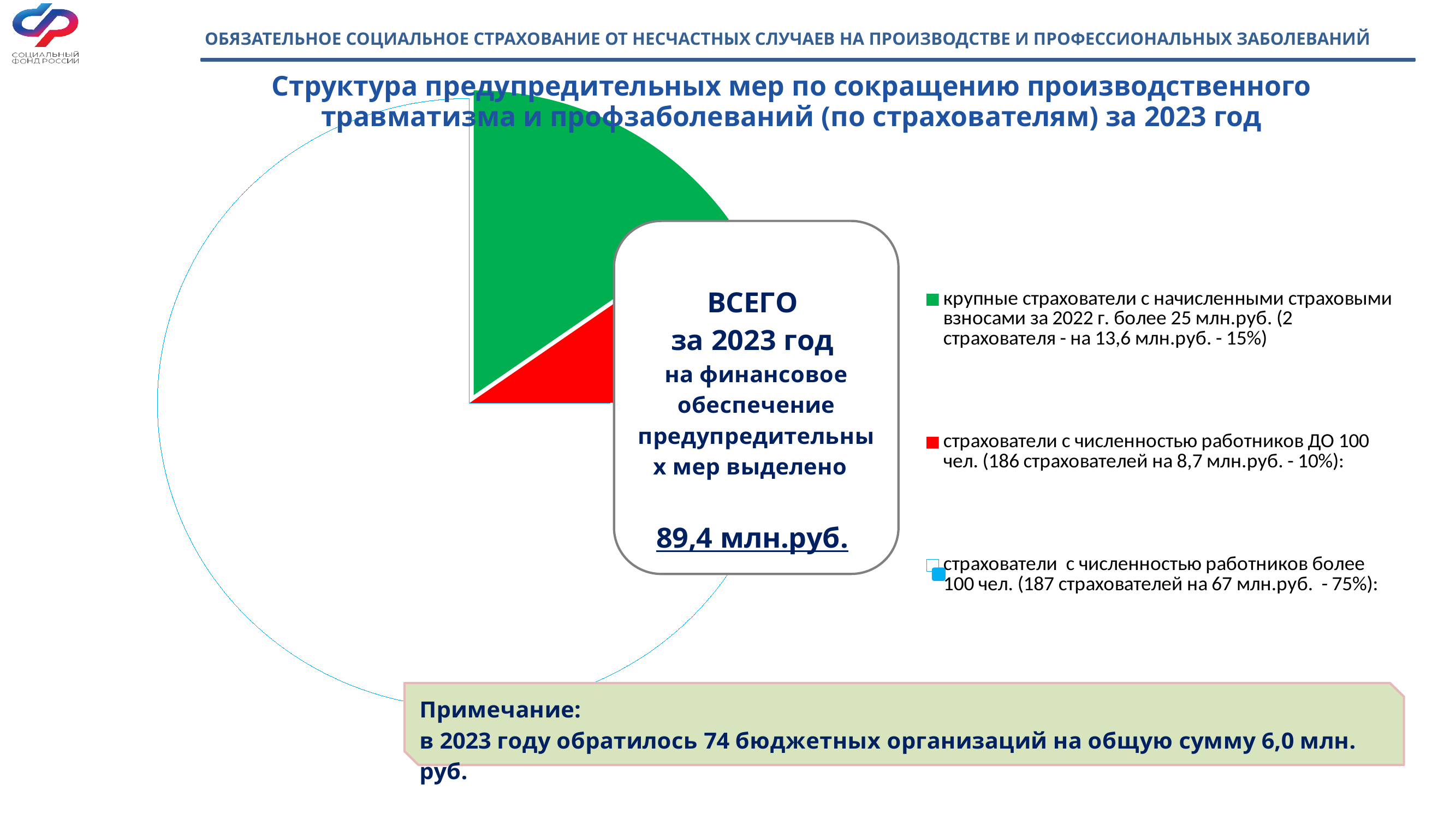
What is the total amount allocated for preventive measures in 2023 shown in the centre of the chart? 89,4 млн.руб. What amount in mln rub. corresponds to large insurers with accrued contributions over 25 mln rub.? 13,6 млн.руб. What share of the pie is taken by large insurers with accrued contributions over 25 mln rub. (крупные страхователи)? 15% What amount in mln rub. corresponds to insurers with more than 100 employees? 67 млн.руб. What kind of chart is shown on the slide? pie chart Which category has the smallest share of the pie? страхователи с численностью работников ДО 100 чел. Which category has the largest share of the pie? страхователи с численностью работников более 100 чел. What share of the pie is taken by insurers with up to 100 employees (страхователи с численностью работников ДО 100 чел.)? 10% What share of the pie is taken by insurers with more than 100 employees (страхователи с численностью работников более 100 чел.)? 75% How many slices does the pie chart have? 3 Which colour represents large insurers with accrued contributions over 25 mln rub. in the legend? green What amount in mln rub. corresponds to insurers with up to 100 employees? 8,7 млн.руб.